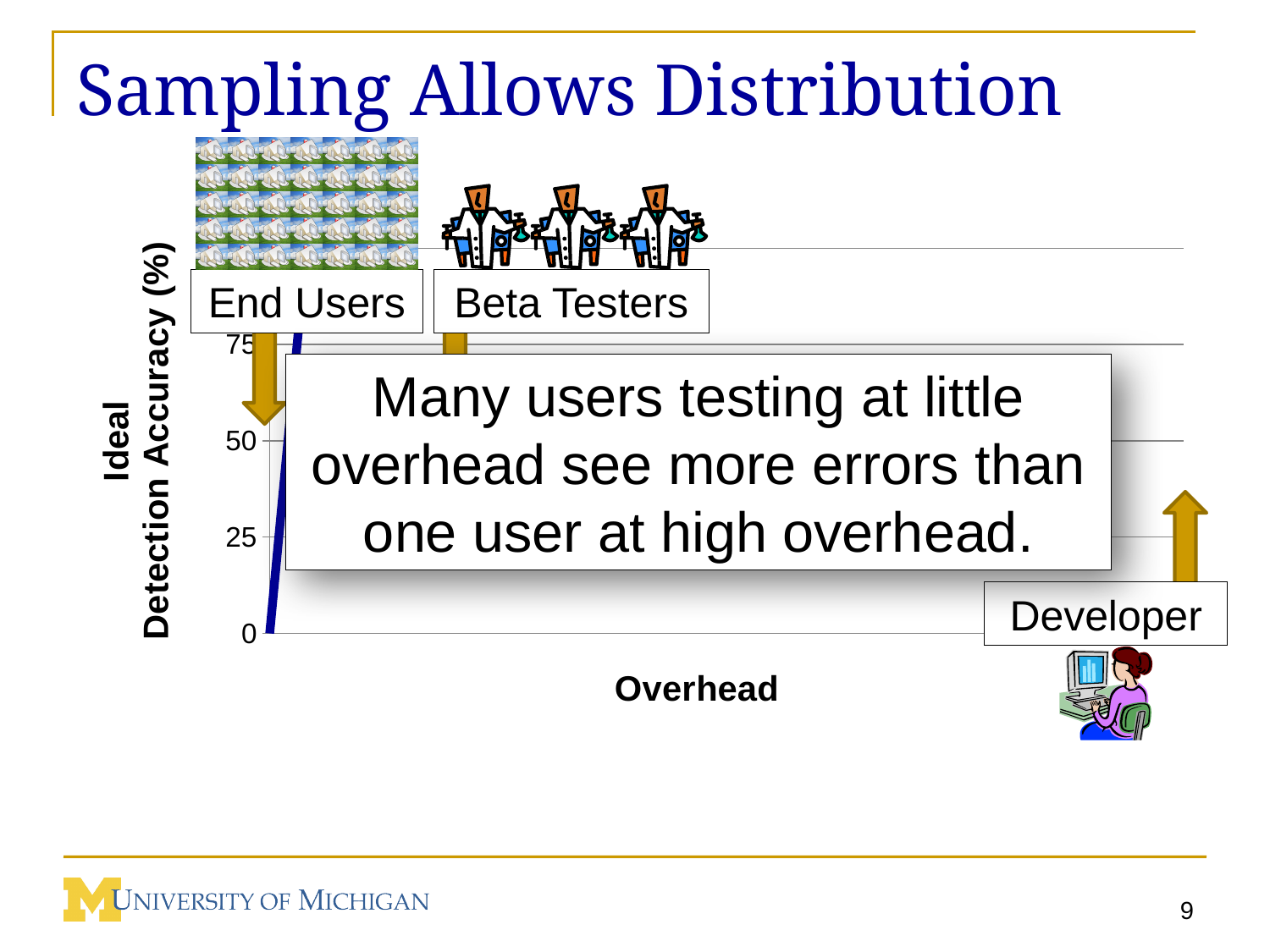
Does the plotted line rise or fall as overhead increases along the x axis? rises What is the title of the y axis of the chart? Ideal Detection Accuracy (%) What kind of chart is shown on the slide? line chart What is the title of the x axis of the chart? Overhead How many user groups are labelled on the chart (End Users, Beta Testers, Developer)? 3